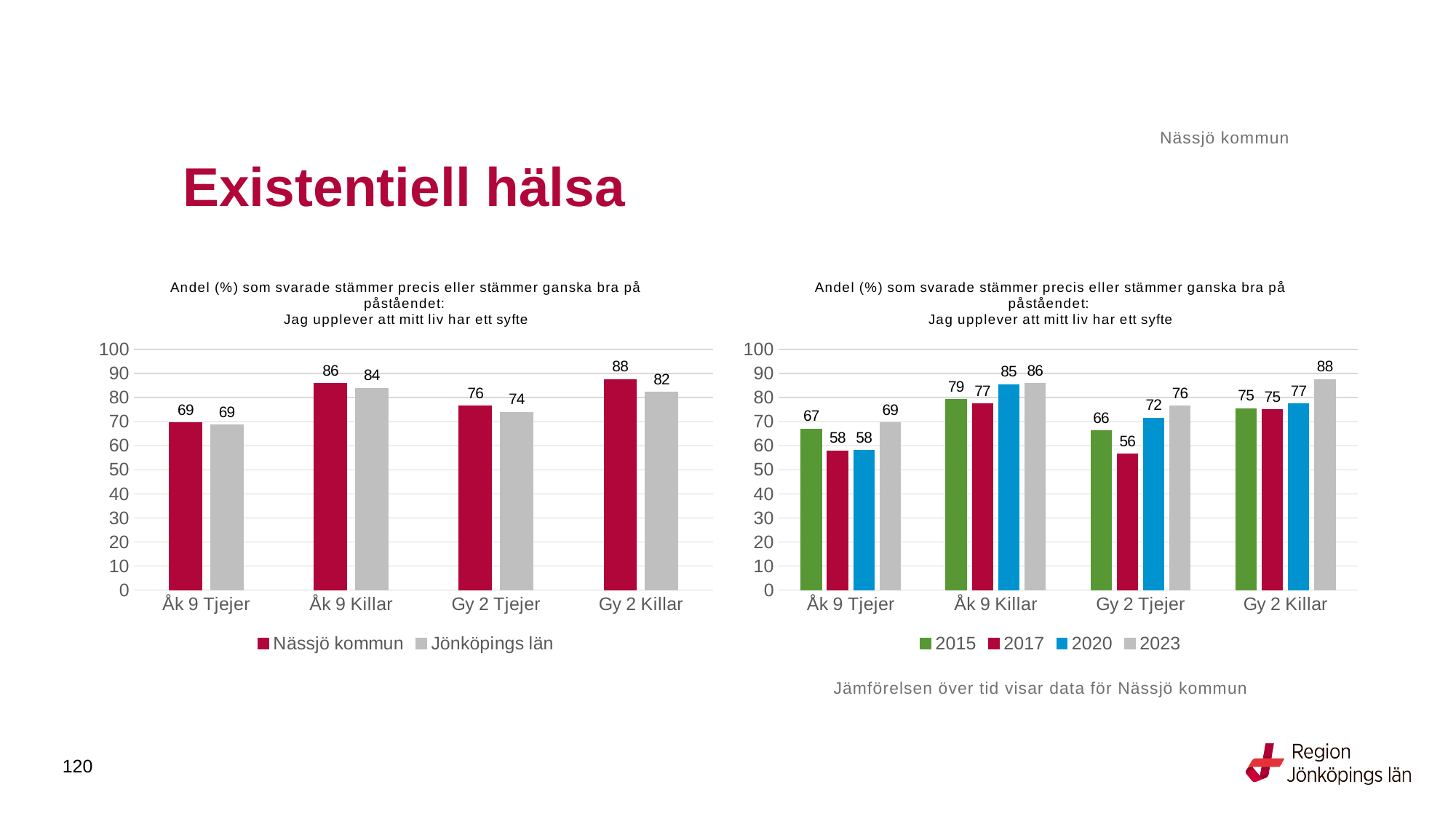
In the right chart, how many series does the legend list? 4 In the right chart, what is the value for 2017 for Gy 2 Tjejer? 56 In the left chart, what is the value for Nässjö kommun for Åk 9 Killar? 86 In the right chart, what is the difference between the 2023 and 2015 values for Gy 2 Killar? 13 What kind of chart is the right chart? Bar chart In the left chart, which category has the highest value for Nässjö kommun? Gy 2 Killar In the right chart, which year has the lowest value for Åk 9 Tjejer? 2017 and 2020 (both 58) In the left chart, how many series does the legend list? 2 In the left chart, what is the value for Jönköpings län for Gy 2 Killar? 82 In the left chart, what is the difference between Nässjö kommun and Jönköpings län for Gy 2 Killar? 6 In the right chart, what is the value for 2020 for Åk 9 Killar? 85 In the right chart, is the value for 2015 for Gy 2 Killar larger or smaller than the value for 2023 for Gy 2 Killar? smaller